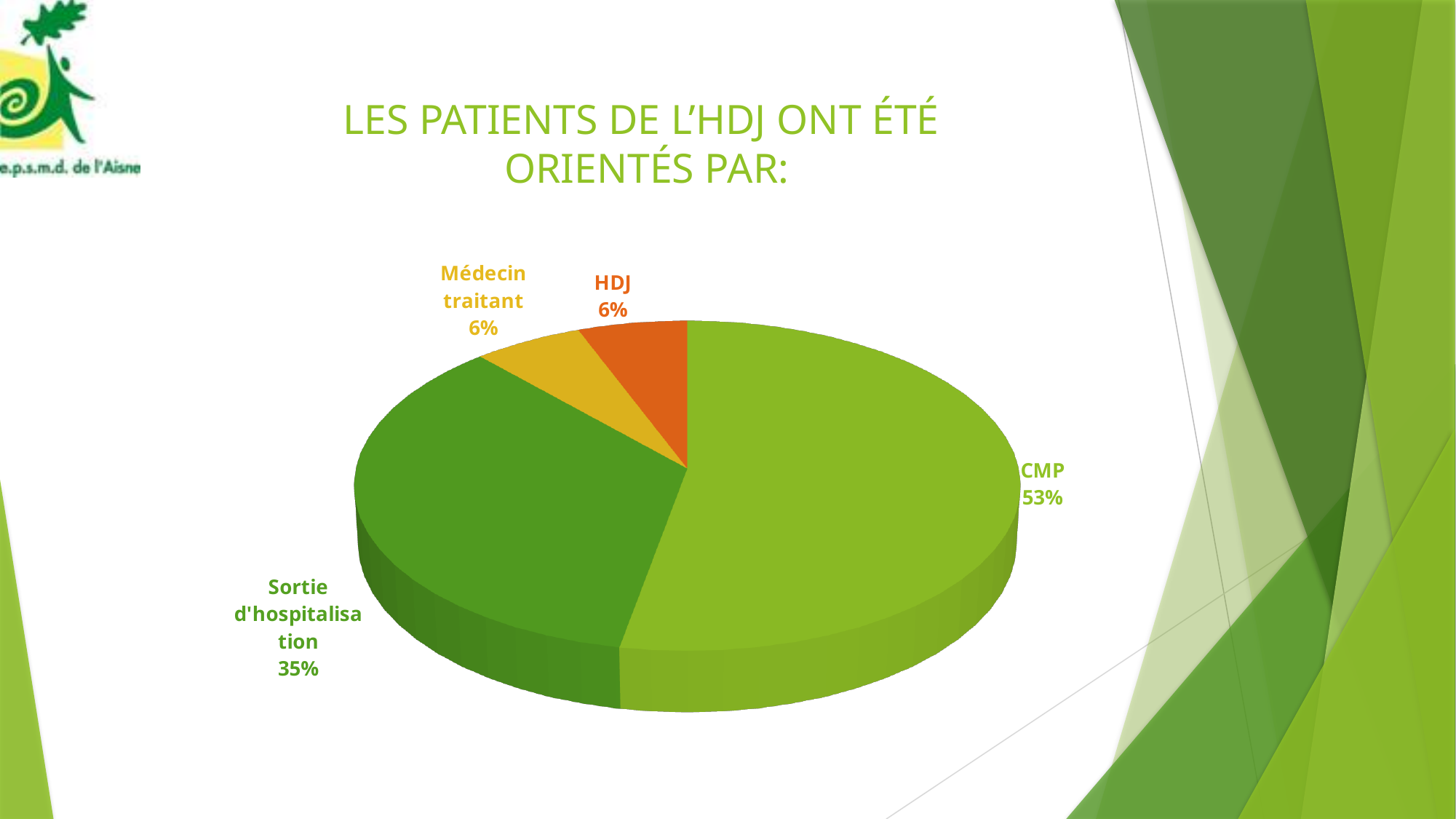
What kind of chart is shown on the slide? Pie chart How many categories are shown in the pie chart? 4 What share of the pie does Médecin traitant represent? 6% Is the share for CMP greater or less than 50%? greater What is the difference in percentage points between CMP and Sortie d'hospitalisation? 18 What share of the pie does HDJ represent? 6% What share of the pie does CMP represent? 53% Which category has the largest share of the pie? CMP What colour is the HDJ slice of the pie? Orange What share of the pie does Sortie d'hospitalisation represent? 35% Which is larger, the share for CMP or the share for Sortie d'hospitalisation? CMP What is the title of the chart on the slide? LES PATIENTS DE L'HDJ ONT ÉTÉ ORIENTÉS PAR: